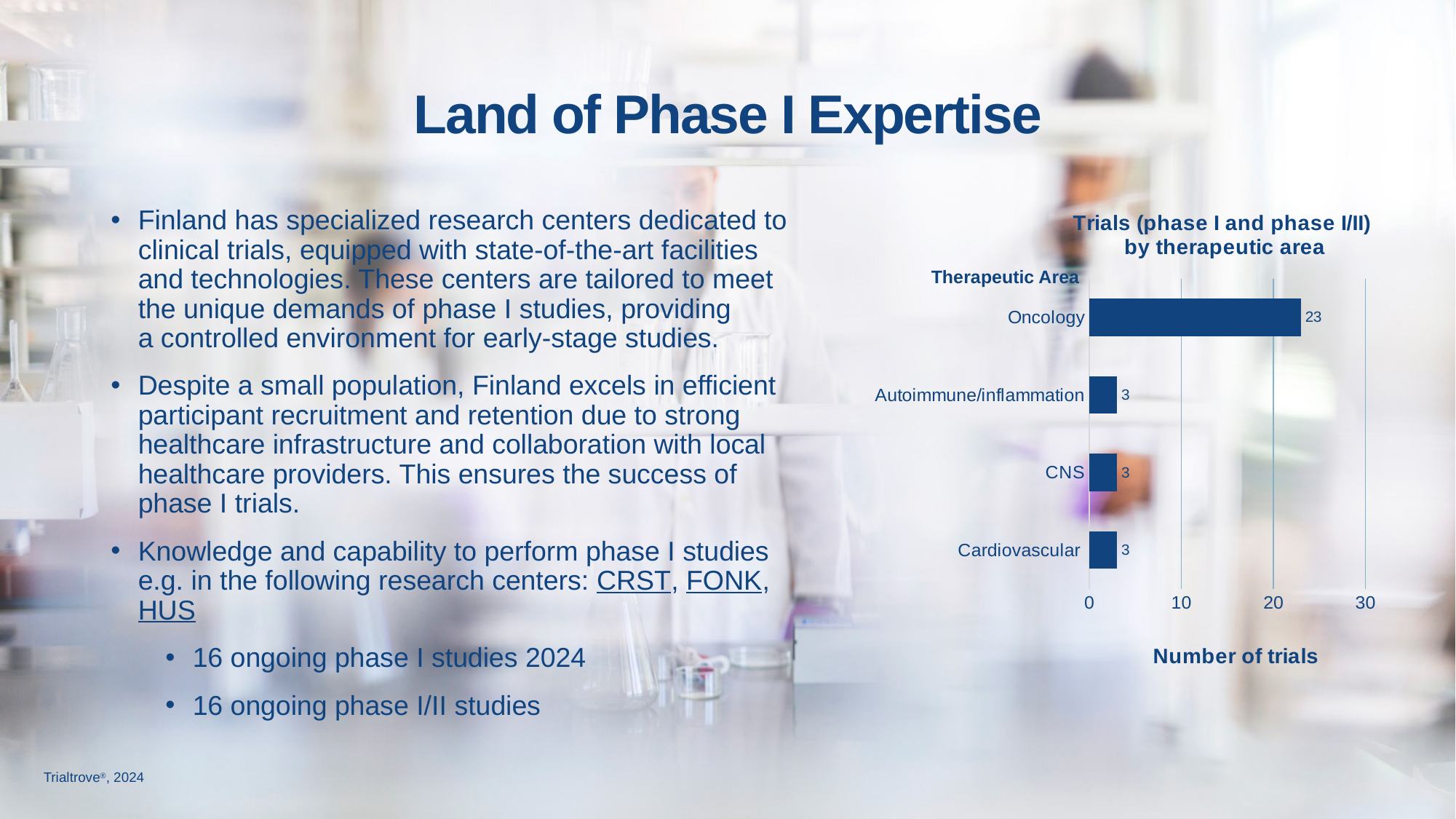
Is the value for Cardiovascular greater or less than 10? less Which has more trials, Oncology or Cardiovascular? Oncology How many trials are shown for Autoimmune/inflammation? 3 How many trials are shown for Cardiovascular? 3 What is the title of the chart? Trials (phase I and phase I/II) by therapeutic area What is the difference in number of trials between Oncology and CNS? 20 How many therapeutic areas are shown in the chart? 4 What kind of chart is used to show trials by therapeutic area? Bar chart How many trials are shown for CNS? 3 How many trials are shown for Oncology? 23 Which therapeutic area has the highest number of trials? Oncology Is the value for Oncology greater or less than 20? greater